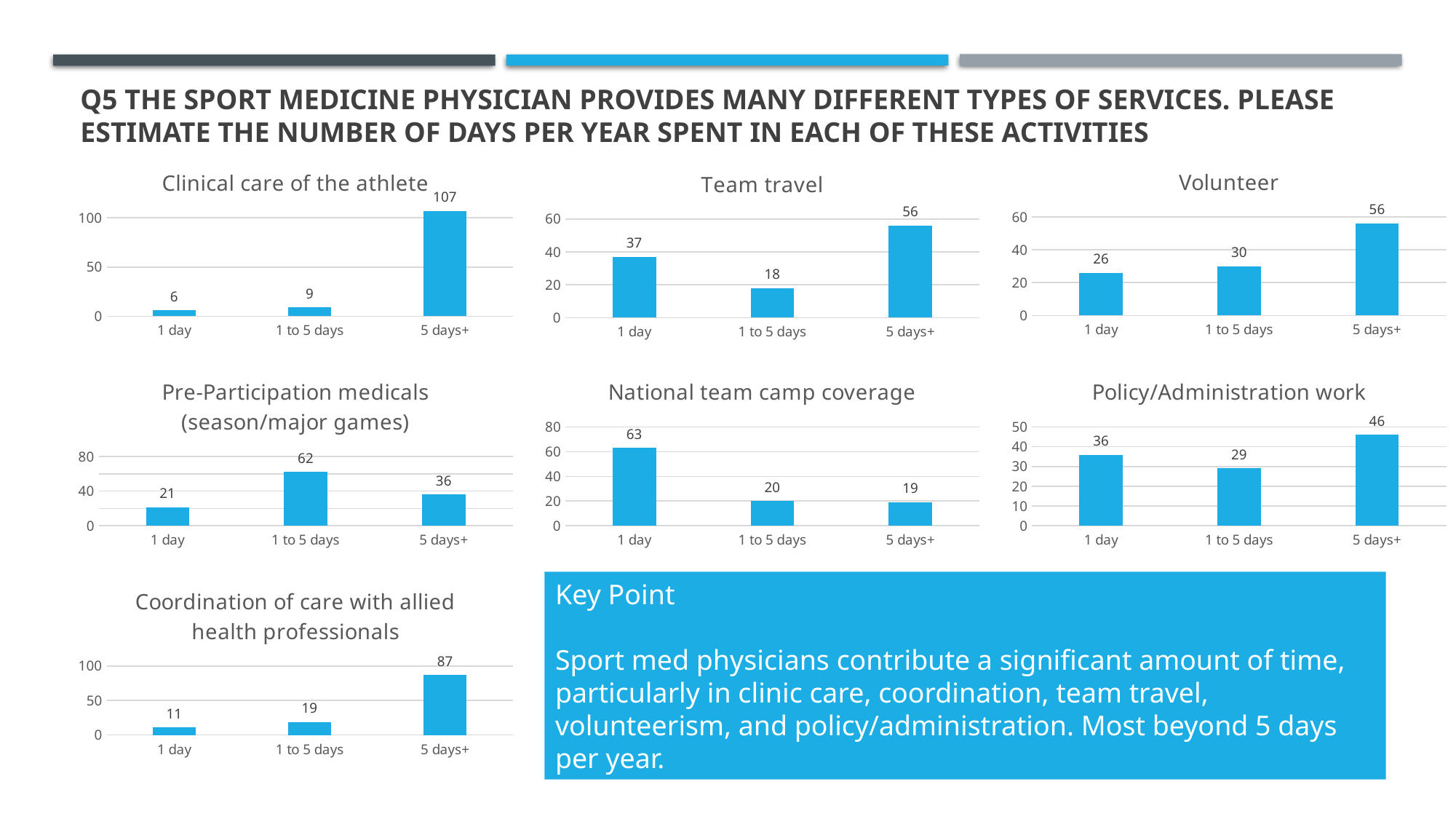
In the 'Volunteer' chart, which category has the highest value? 5 days+ How many charts are shown on the slide? 7 What kind of chart is the 'Volunteer' chart? bar chart How many categories are shown in the 'Team travel' chart? 3 In the 'Coordination of care with allied health professionals' chart, what is the value for '1 day'? 11 In the 'Clinical care of the athlete' chart, what is the value for '5 days+'? 107 In the 'Policy/Administration work' chart, what is the difference between the '5 days+' and '1 to 5 days' values? 17 In the 'Pre-Participation medicals (season/major games)' chart, which is larger, the value for '1 to 5 days' or the value for '5 days+'? 1 to 5 days In the 'Team travel' chart, what is the value for '1 to 5 days'? 18 In the 'Volunteer' chart, do the values rise or fall from '1 day' to '5 days+'? rise In the 'National team camp coverage' chart, what is the value for '1 day'? 63 In the 'National team camp coverage' chart, which category has the lowest value? 5 days+